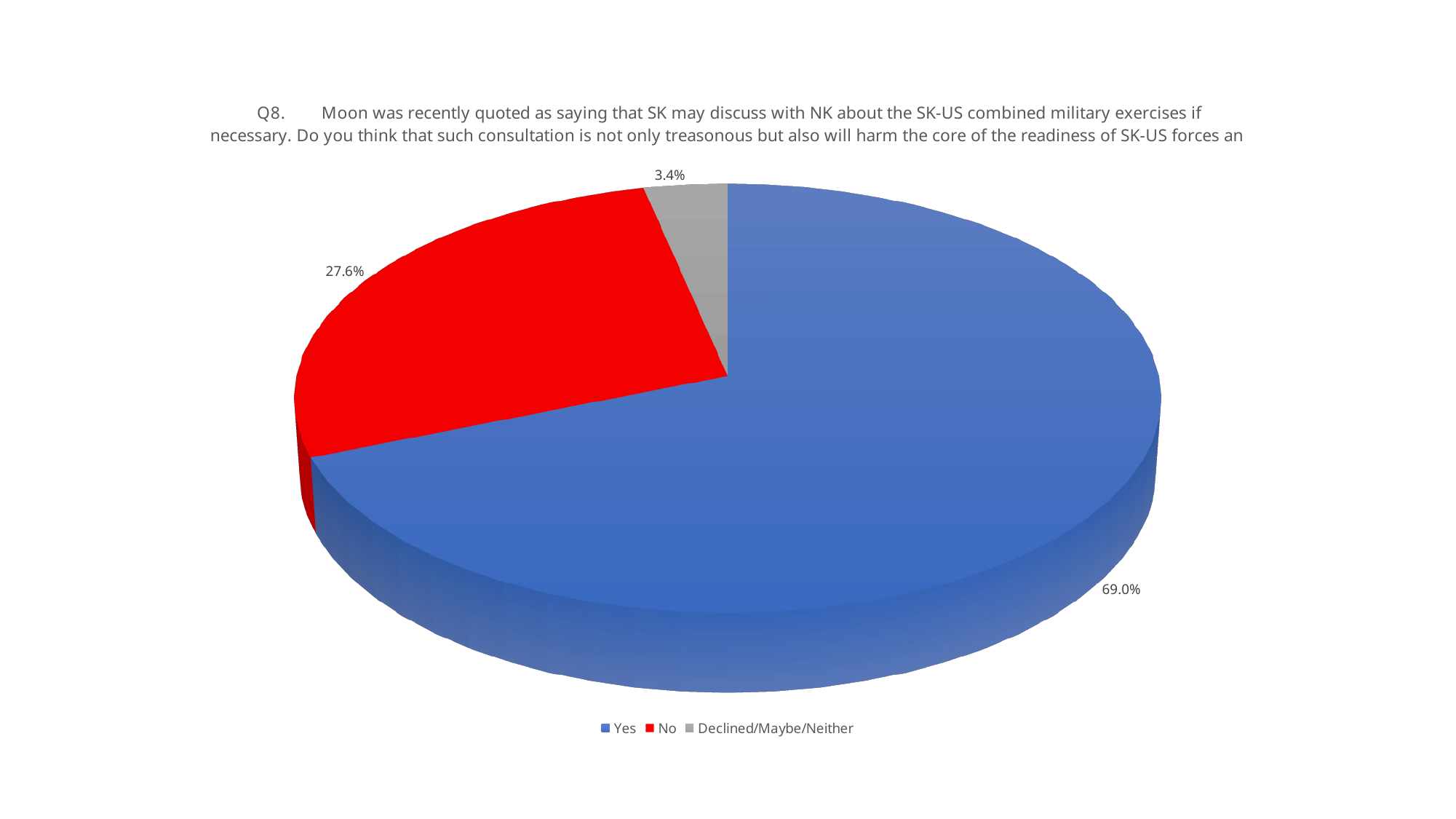
Which is larger, the share for No or the share for Declined/Maybe/Neither? No What percentage of respondents answered Yes? 69.0% What is the difference in percentage points between the Yes and No shares? 41.4 What is the combined share of the No and Declined/Maybe/Neither categories? 31.0% How many categories does the pie chart show? 3 Which response category has the smallest share of the pie? Declined/Maybe/Neither What is the label of the third legend entry? Declined/Maybe/Neither What colour represents the No category in the pie chart? Red What percentage of respondents are in the Declined/Maybe/Neither category? 3.4% What kind of chart is shown on the slide? Pie chart What percentage of respondents answered No? 27.6% Which response category has the largest share of the pie? Yes